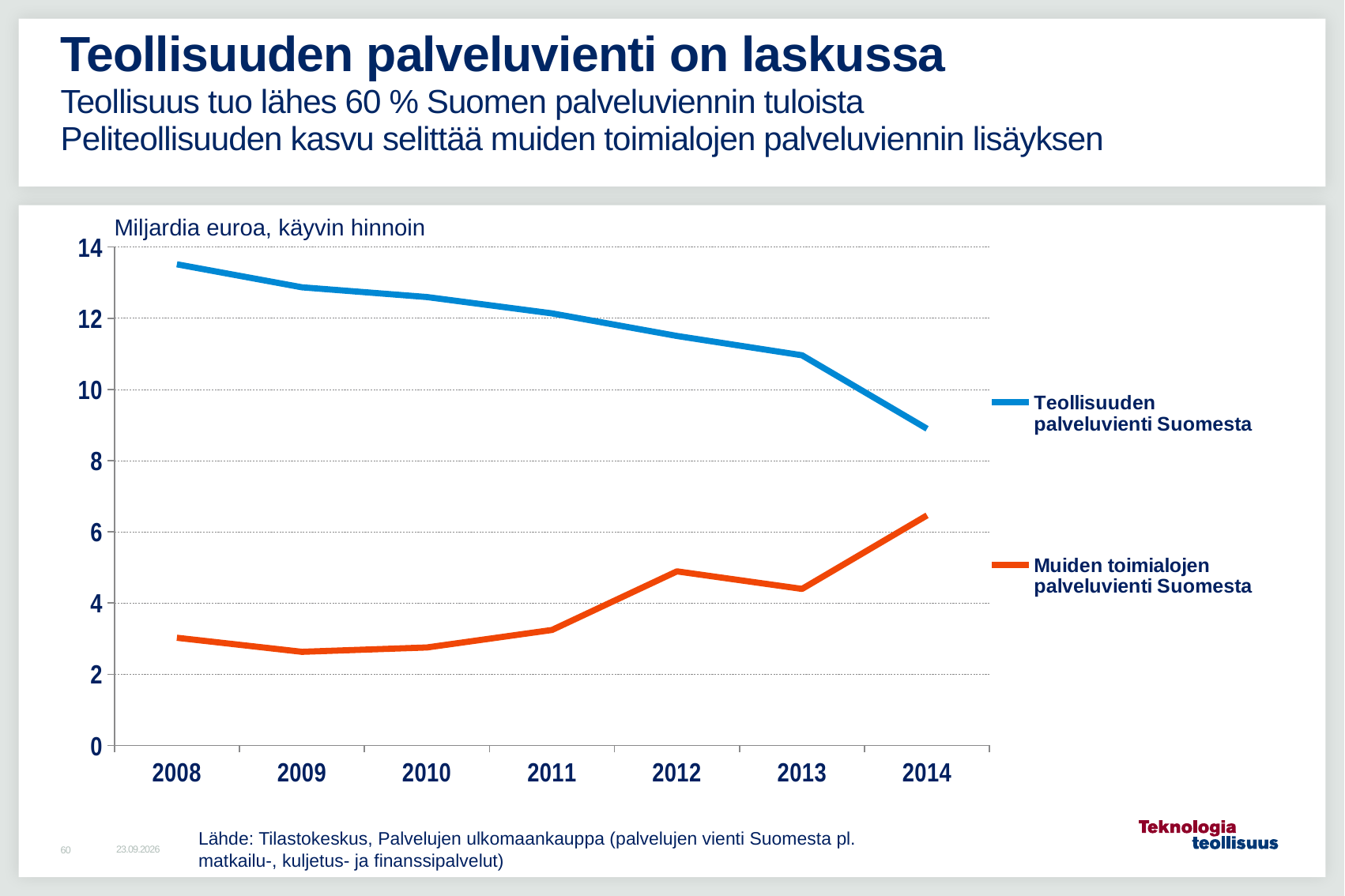
What unit is given above the y axis of the chart? Miljardia euroa, käyvin hinnoin What kind of chart is shown on the slide? line chart How many series does the legend list? 2 In which year is Muiden toimialojen palveluvienti Suomesta highest? 2014 Is the value for Teollisuuden palveluvienti Suomesta in 2014 greater or less than 10? less Does the value for Muiden toimialojen palveluvienti Suomesta rise or fall from 2010 to 2014? rise Does the value for Teollisuuden palveluvienti Suomesta rise or fall from 2008 to 2014? fall How many years are shown on the x axis? 7 In 2014, which series has the higher value, Teollisuuden palveluvienti Suomesta or Muiden toimialojen palveluvienti Suomesta? Teollisuuden palveluvienti Suomesta Is the value for Muiden toimialojen palveluvienti Suomesta in 2014 greater or less than 6? greater In which year is Teollisuuden palveluvienti Suomesta lowest? 2014 In which year is Teollisuuden palveluvienti Suomesta highest? 2008